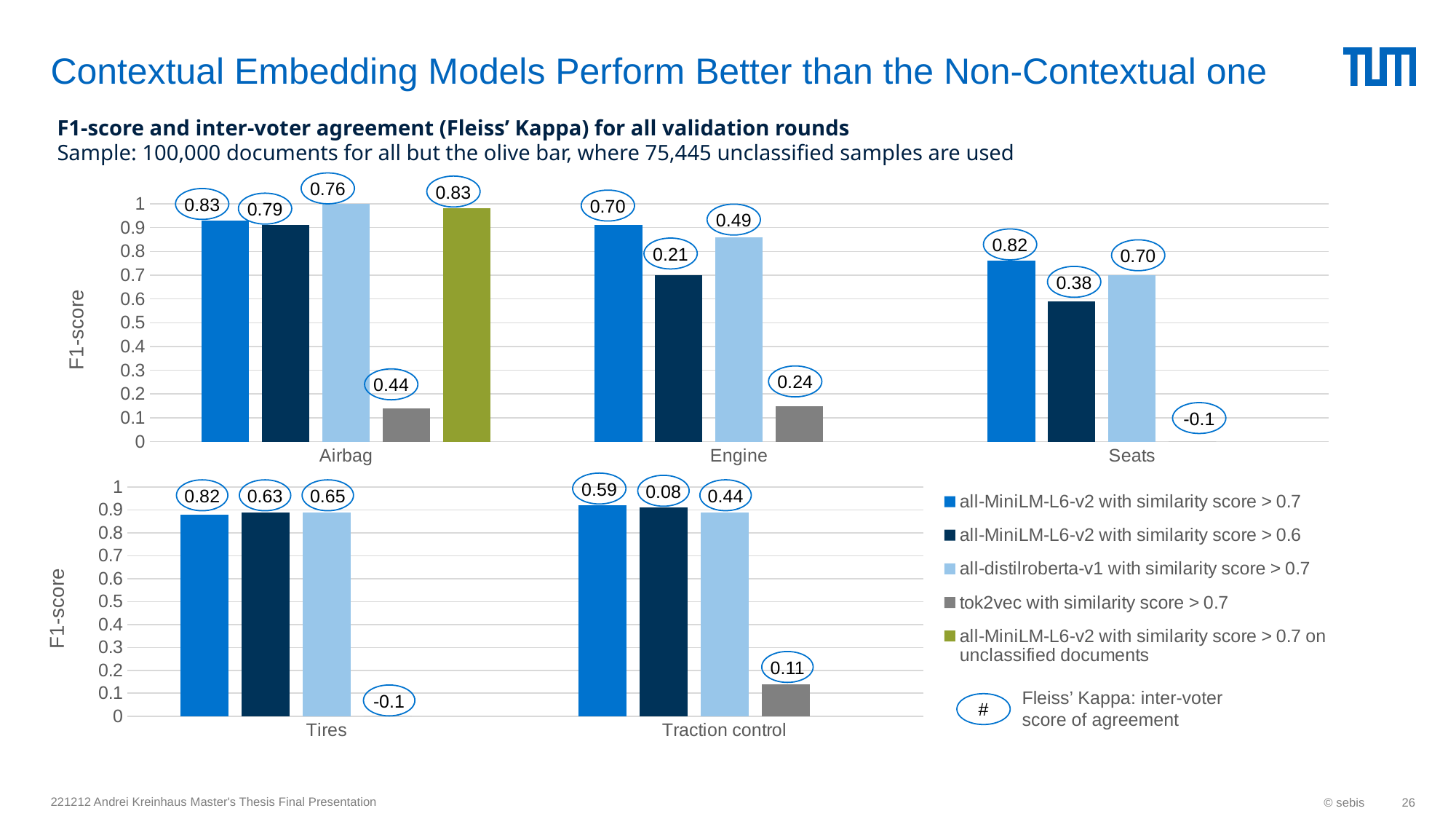
In the top chart, what Fleiss' Kappa value is shown for tok2vec with similarity score > 0.7 for Airbag? 0.44 In the top chart, is the F1-score of tok2vec with similarity score > 0.7 for Airbag greater or less than 0.5? less What type of chart is the top chart on the slide? bar chart In the top chart, which series has the lowest F1-score for Airbag? tok2vec with similarity score > 0.7 How many categories are shown on the x axis of the top chart? 3 In the bottom chart, what Fleiss' Kappa value is shown for all-MiniLM-L6-v2 with similarity score > 0.6 for Traction control? 0.08 In the top chart, is the F1-score of all-MiniLM-L6-v2 with similarity score > 0.6 for Engine greater or less than 0.5? greater How many series does the legend list? 5 In the bottom chart, is the F1-score of tok2vec with similarity score > 0.7 for Traction control greater or less than 0.5? less How many categories are shown on the x axis of the bottom chart? 2 In the top chart, for Engine, which has the higher F1-score: all-MiniLM-L6-v2 with similarity score > 0.7 or all-MiniLM-L6-v2 with similarity score > 0.6? all-MiniLM-L6-v2 with similarity score > 0.7